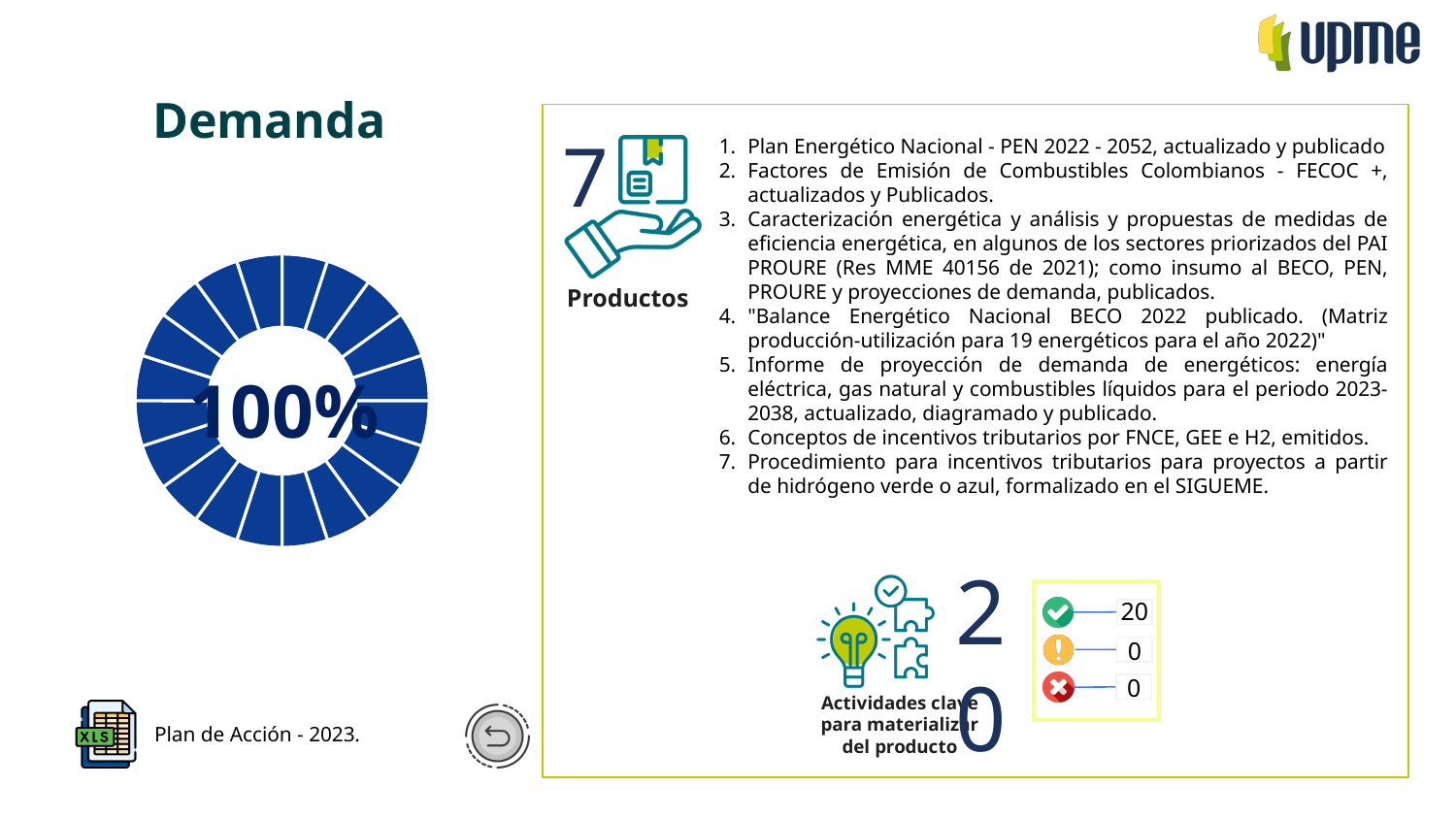
What percentage is displayed in the center of the doughnut chart? 100% What kind of chart is shown on the left side of the slide? doughnut chart What colour are the segments of the doughnut chart? blue What is the title of the slide containing the doughnut chart? Demanda Does the doughnut chart show a completion value of 100%? yes